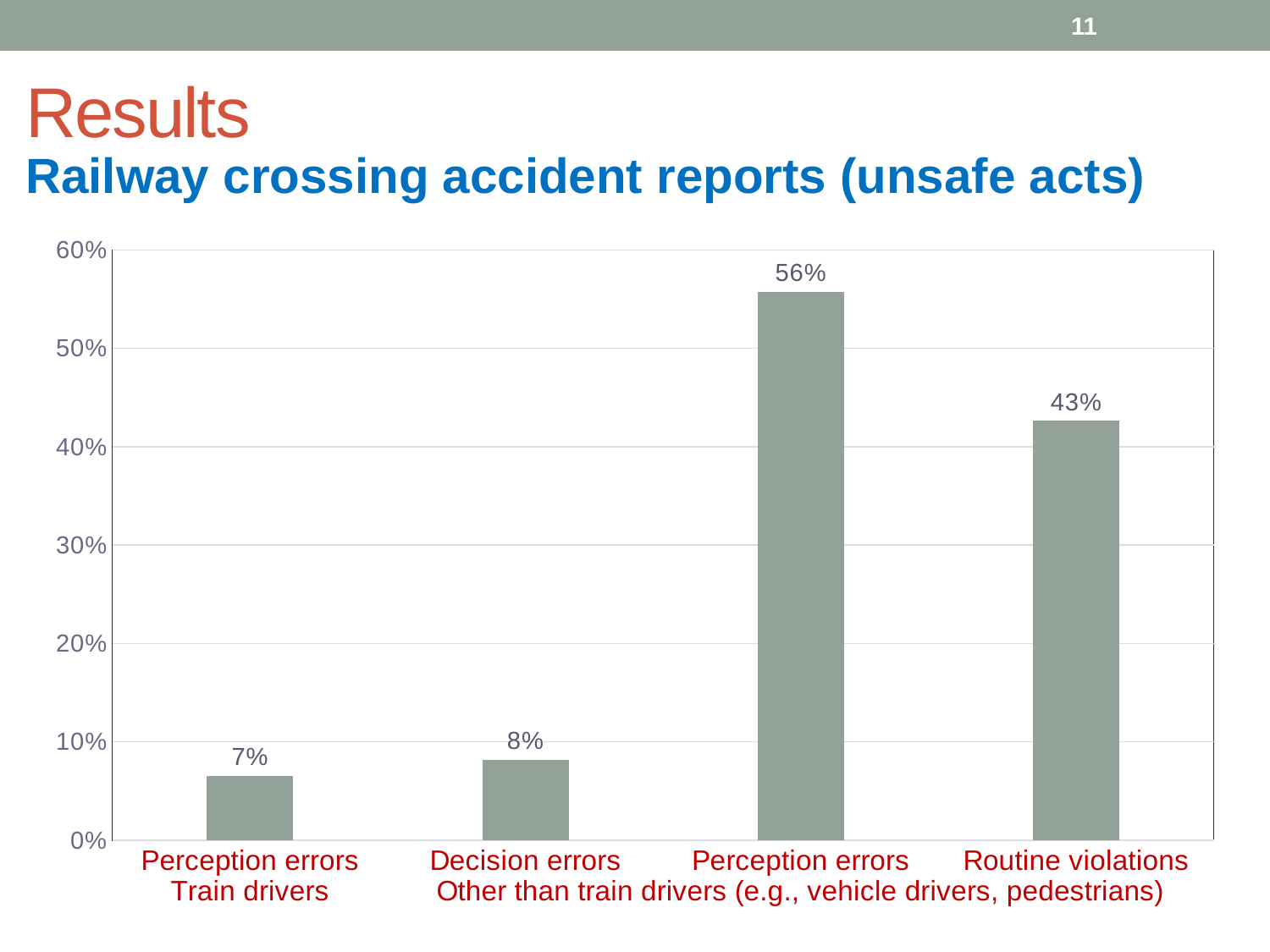
Which category has the highest value? Perception errors (other than train drivers) Which is larger, Routine violations or Perception errors among other than train drivers? Perception errors among other than train drivers What is the value for Routine violations? 43% What is the difference between Decision errors and Perception errors among train drivers? 1% What kind of chart is shown on the slide? Bar chart What is the value for Perception errors among other than train drivers? 56% What is the value for Perception errors among train drivers? 7% Which category has the lowest value? Perception errors (train drivers) What is the difference between Perception errors among other than train drivers and Routine violations? 13% What is the subtitle of the slide describing the chart? Railway crossing accident reports (unsafe acts) What is the value for Decision errors among other than train drivers? 8% How many bars are shown in the chart? 4